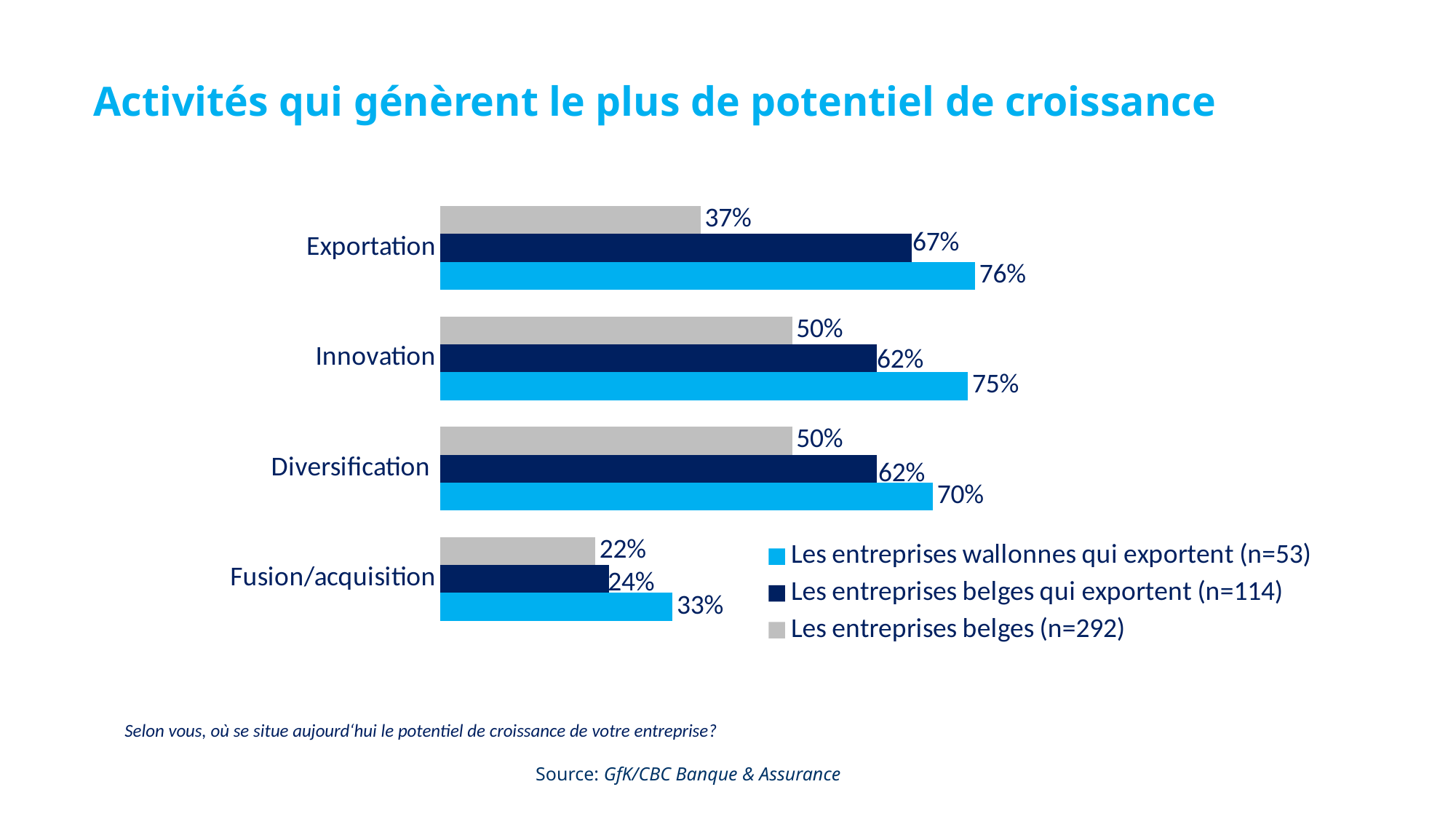
What is the title of the chart? Activités qui génèrent le plus de potentiel de croissance What is the difference between Les entreprises wallonnes qui exportent (n=53) and Les entreprises belges (n=292) for Exportation? 39% What is the value for Fusion/acquisition for Les entreprises belges qui exportent (n=114)? 24% How many series does the legend list? 3 Which series is shown in grey? Les entreprises belges (n=292) For Diversification, which is larger: Les entreprises wallonnes qui exportent (n=53) or Les entreprises belges qui exportent (n=114)? Les entreprises wallonnes qui exportent (n=53) What kind of chart is shown on the slide? Bar chart Which category has the lowest value for Les entreprises belges (n=292)? Fusion/acquisition What is the value for Exportation for Les entreprises wallonnes qui exportent (n=53)? 76% How many categories are shown on the chart? 4 What is the value for Innovation for Les entreprises belges (n=292)? 50% Which category has the highest value for Les entreprises wallonnes qui exportent (n=53)? Exportation